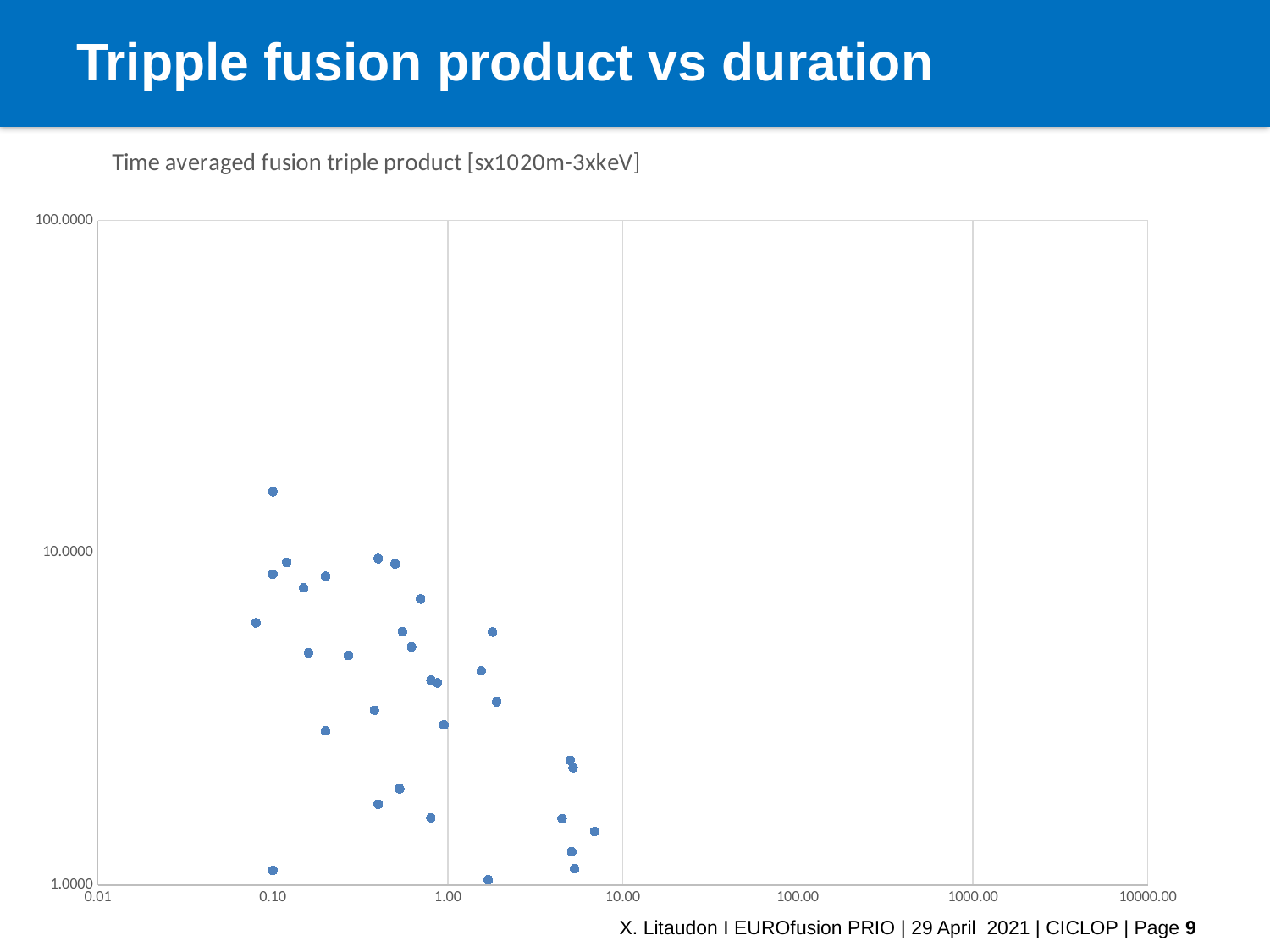
Is the highest plotted point greater or less than 10.0000 on the y axis? greater Do the plotted values generally rise or fall as the x-axis value increases? fall Is the highest plotted point located at an x value greater or less than 1.00? less Is the highest plotted point greater or less than 100.0000 on the y axis? less What is the title of the chart? Time averaged fusion triple product [sx1020m-3xkeV] What kind of chart is shown on the slide? scatter chart What is the largest tick value shown on the x axis? 10000.00